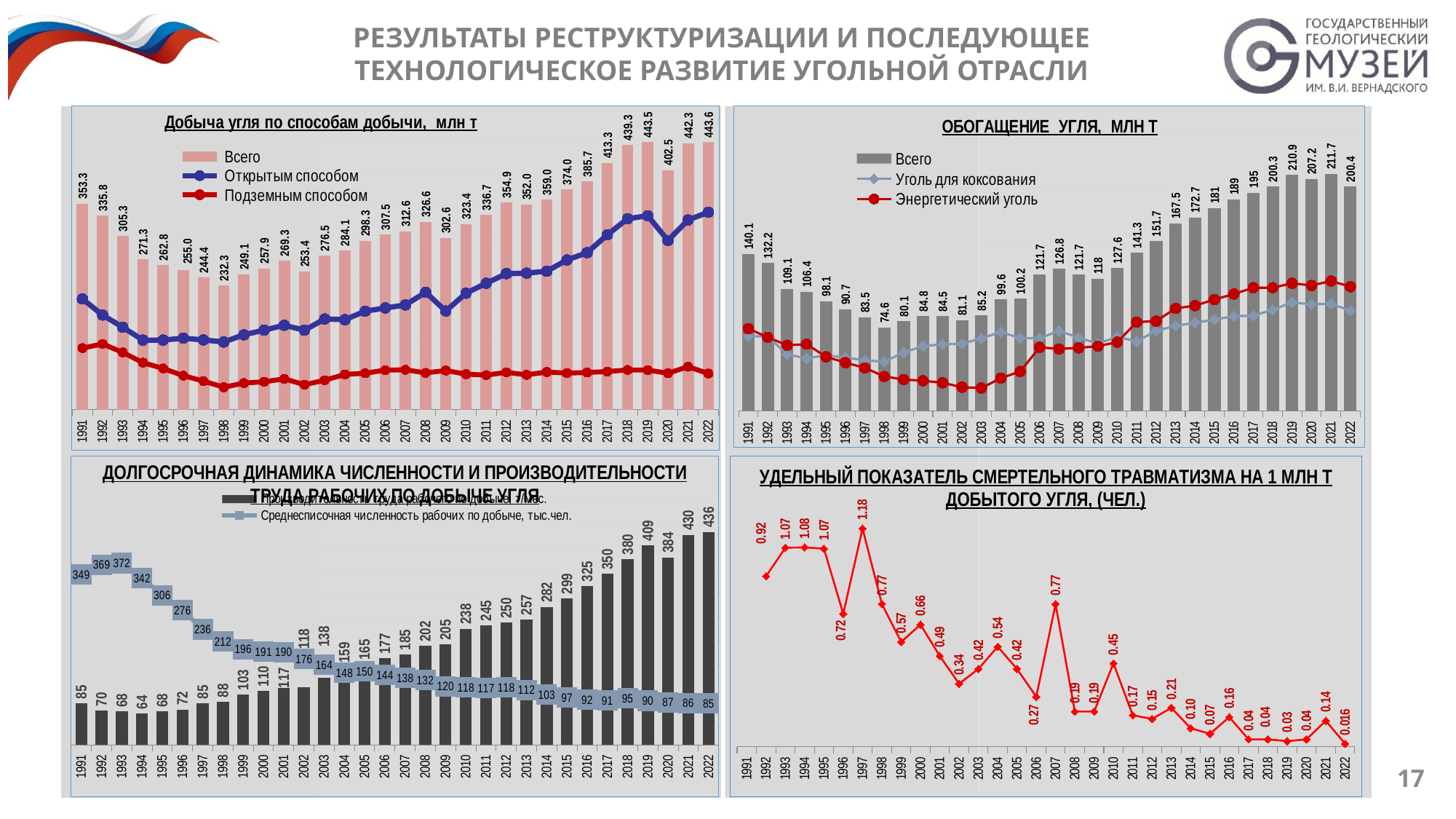
In the bottom-left chart on labour productivity and workforce, what is the workforce (тыс.чел.) value for 1993? 372 In the chart 'УДЕЛЬНЫЙ ПОКАЗАТЕЛЬ СМЕРТЕЛЬНОГО ТРАВМАТИЗМА', which year has the highest value? 1997 In the bottom-left chart on labour productivity and workforce, what is the productivity bar value for 2022? 436 In the chart 'ОБОГАЩЕНИЕ УГЛЯ, МЛН Т', which year has the lowest 'Всего' value? 1998 In the chart 'УДЕЛЬНЫЙ ПОКАЗАТЕЛЬ СМЕРТЕЛЬНОГО ТРАВМАТИЗМА', what is the value for 2022? 0.016 In the chart 'ОБОГАЩЕНИЕ УГЛЯ, МЛН Т', what is the 'Всего' value for 2021? 211.7 In the chart 'ОБОГАЩЕНИЕ УГЛЯ, МЛН Т', which is larger: the 'Всего' value for 2019 or for 2022? 2019 In the chart 'Добыча угля по способам добычи, млн т', which year has the lowest 'Всего' value? 1998 In the chart 'Добыча угля по способам добычи, млн т', what is the value of 'Всего' for 1991? 353.3 In the chart 'Добыча угля по способам добычи, млн т', what is the difference between the 'Всего' values for 2022 and 2020? 41.1 In the bottom-left chart on labour productivity and workforce, does the workforce line rise or fall from 1993 to 2022? fall How many series does the legend of the chart 'Добыча угля по способам добычи, млн т' list? 3